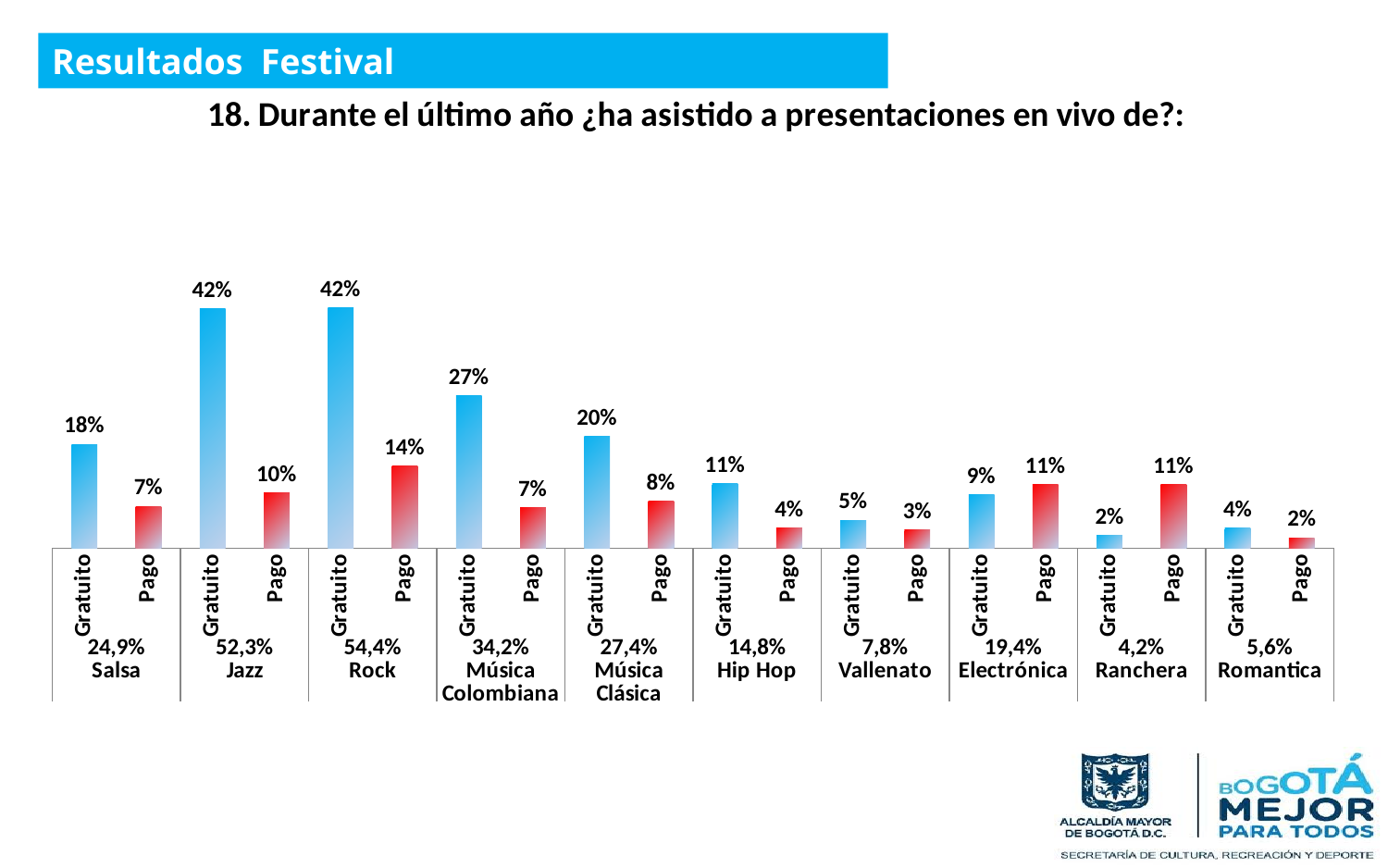
What is the difference between the Gratuito and Pago values for Jazz? 32% What is the Pago value for Electrónica? 11% What is the Pago value for Rock? 14% What percentage is printed next to the Vallenato category label? 7,8% What is the Gratuito value for Música Colombiana? 27% Which is larger for Ranchera, the Gratuito value or the Pago value? Pago Which genre has the highest Pago value? Rock Which genre has the lowest Gratuito value? Ranchera What kind of chart is shown on the slide? Bar chart What is the Gratuito value for Salsa? 18% Which is larger, the Gratuito value for Música Clásica or the Gratuito value for Hip Hop? Música Clásica How many music genres are shown on the chart? 10